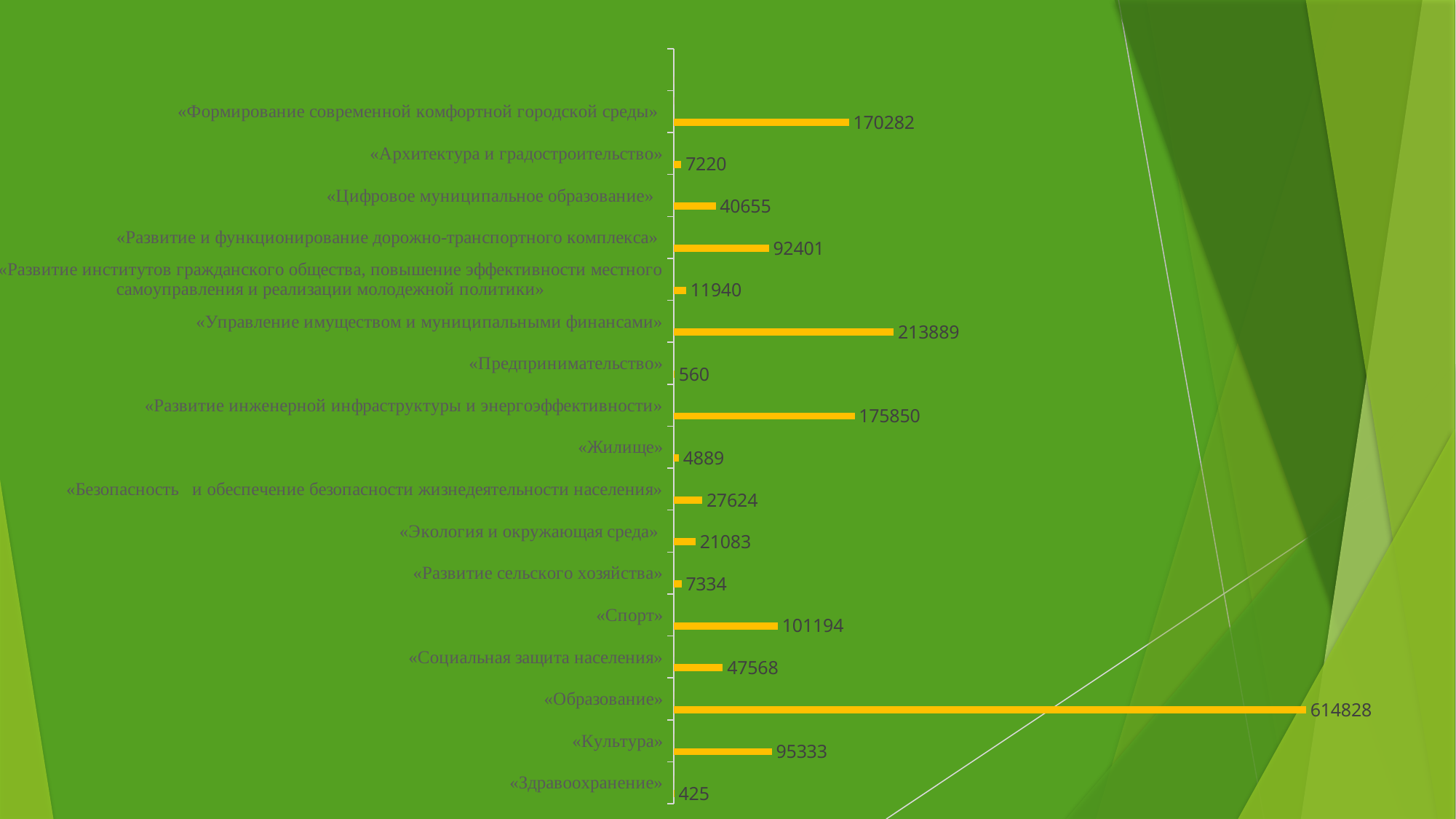
Which category has the lowest value? «Здравоохранение» What is the difference between the values for «Спорт» and «Культура»? 5861 What is the value for «Управление имуществом и муниципальными финансами»? 213889 What kind of chart is shown on the slide? bar chart What colour are the bars in the chart? yellow What is the value for «Предпринимательство»? 560 Which has the larger value, «Развитие инженерной инфраструктуры и энергоэффективности» or «Формирование современной комфортной городской среды»? «Развитие инженерной инфраструктуры и энергоэффективности» Which category has the highest value? «Образование» What is the value for «Образование»? 614828 What is the value for «Спорт»? 101194 What is the difference between the values for «Образование» and «Управление имуществом и муниципальными финансами»? 400939 How many categories are plotted in the chart? 17